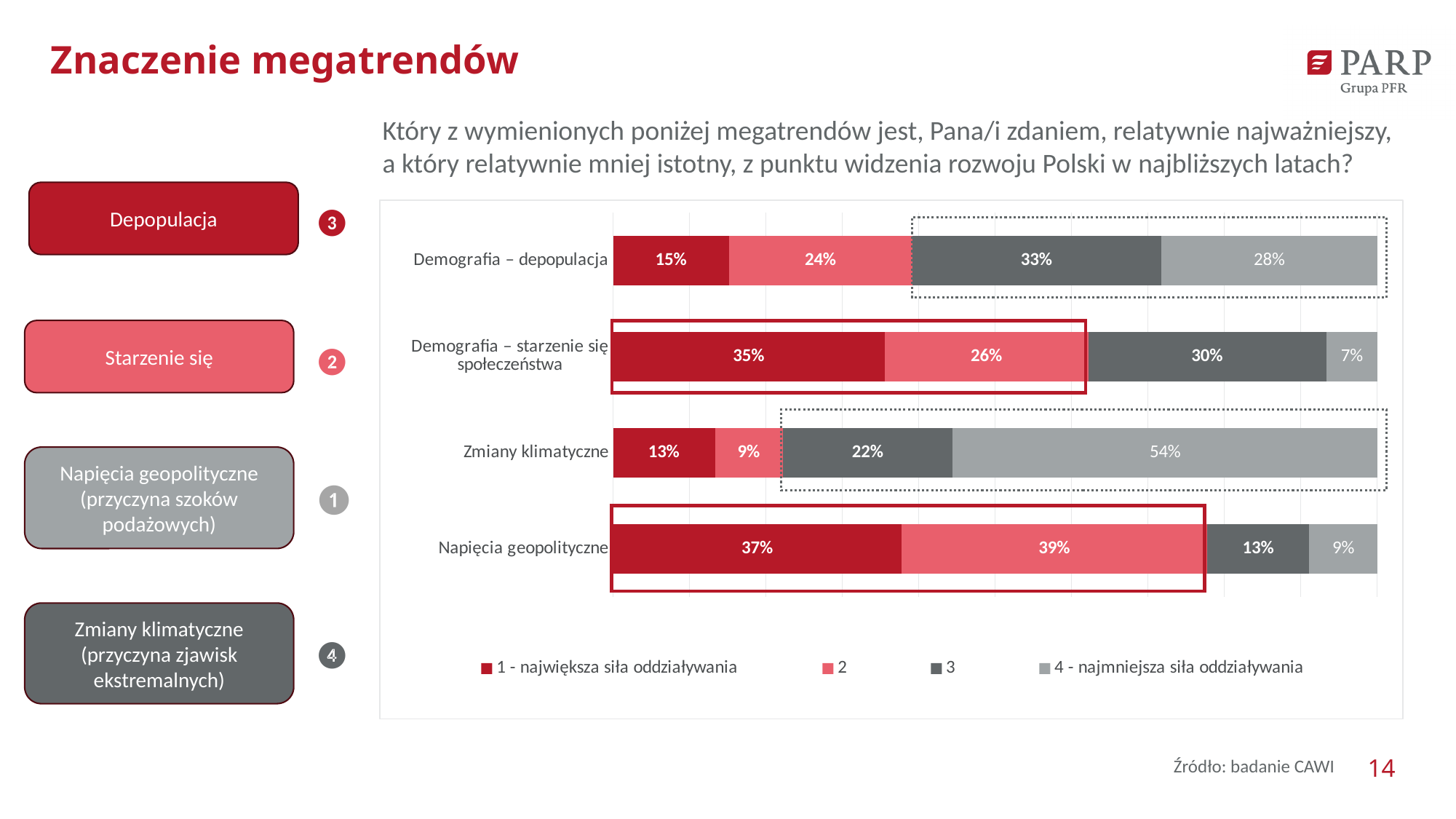
Which category has the lowest value for series '4 - najmniejsza siła oddziaływania'? Demografia – starzenie się społeczeństwa Which category has the highest value for series '1 - największa siła oddziaływania'? Napięcia geopolityczne What is the value of series '3' for 'Demografia – depopulacja'? 33% How many categories (megatrends) are plotted in the chart? 4 What is the value of series '2' for 'Demografia – starzenie się społeczeństwa'? 26% What type of chart is shown on the slide? Stacked bar chart What is the value of series '4 - najmniejsza siła oddziaływania' for 'Zmiany klimatyczne'? 54% How many series does the chart legend list? 4 What is the label of the first legend entry in the chart? 1 - największa siła oddziaływania What is the difference between the series '2' values for 'Napięcia geopolityczne' and 'Zmiany klimatyczne'? 30% What is the value of series '1 - największa siła oddziaływania' for 'Napięcia geopolityczne'? 37% Which is larger: the series '3' value for 'Demografia – starzenie się społeczeństwa' or for 'Zmiany klimatyczne'? Demografia – starzenie się społeczeństwa